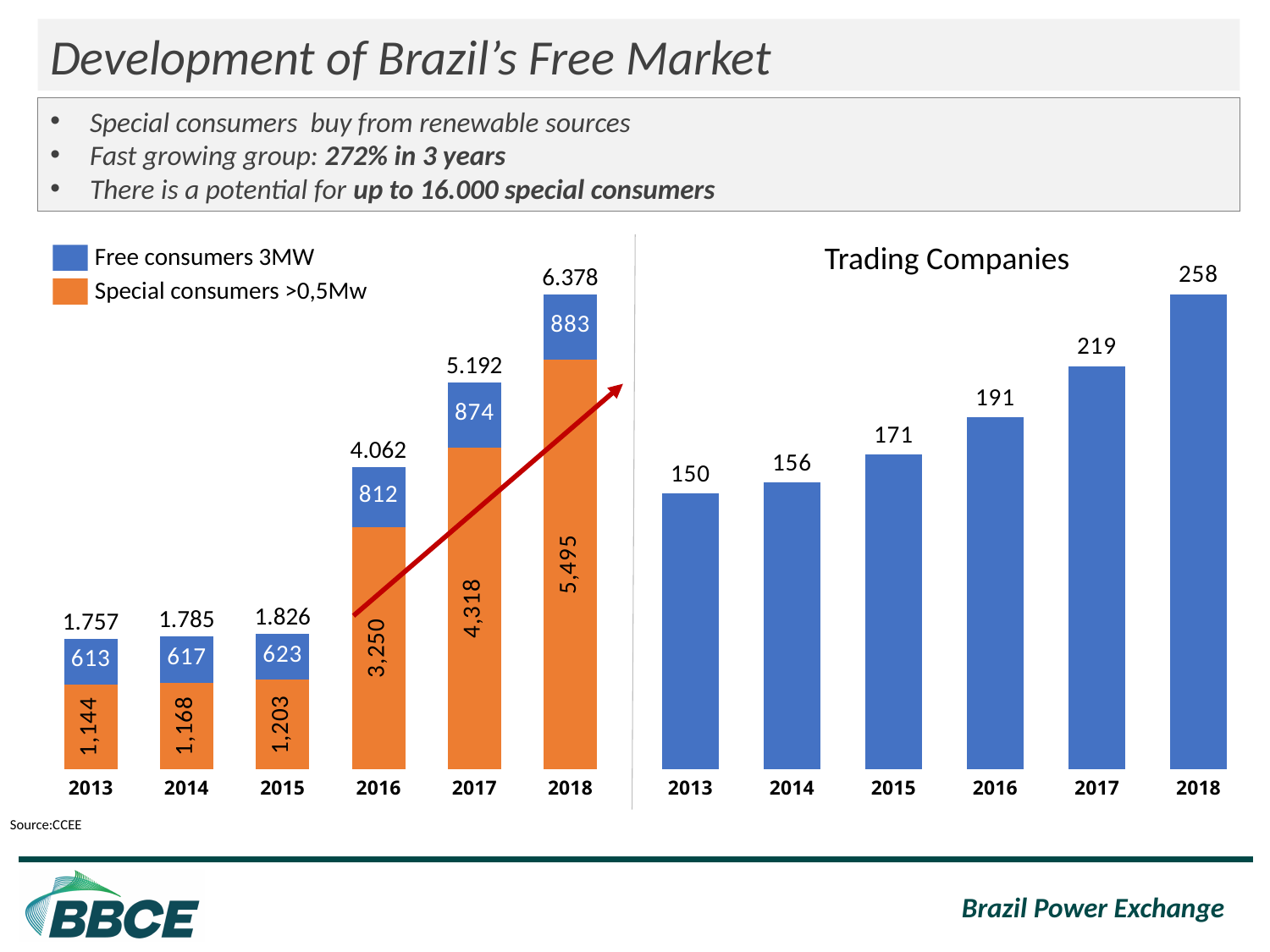
In the Trading Companies chart, do the values rise or fall from 2013 to 2018? rise In the stacked bar chart on the left, what is the value for Free consumers 3MW in 2016? 812 In the Trading Companies chart, how many years are shown? 6 In the stacked bar chart on the left, what is the value for Special consumers >0,5Mw in 2017? 4,318 In the Trading Companies chart, what is the value for 2016? 191 In the Trading Companies chart, what is the difference between the 2018 and 2013 values? 108 In the stacked bar chart on the left, which year has the lowest total? 2013 In the Trading Companies chart, which year has the highest value? 2018 In the stacked bar chart on the left, which is larger in 2015: Special consumers >0,5Mw or Free consumers 3MW? Special consumers >0,5Mw How many series does the legend of the stacked bar chart on the left list? 2 What type of chart is the Trading Companies chart? bar chart In the stacked bar chart on the left, what is the total of the 2018 bar? 6.378